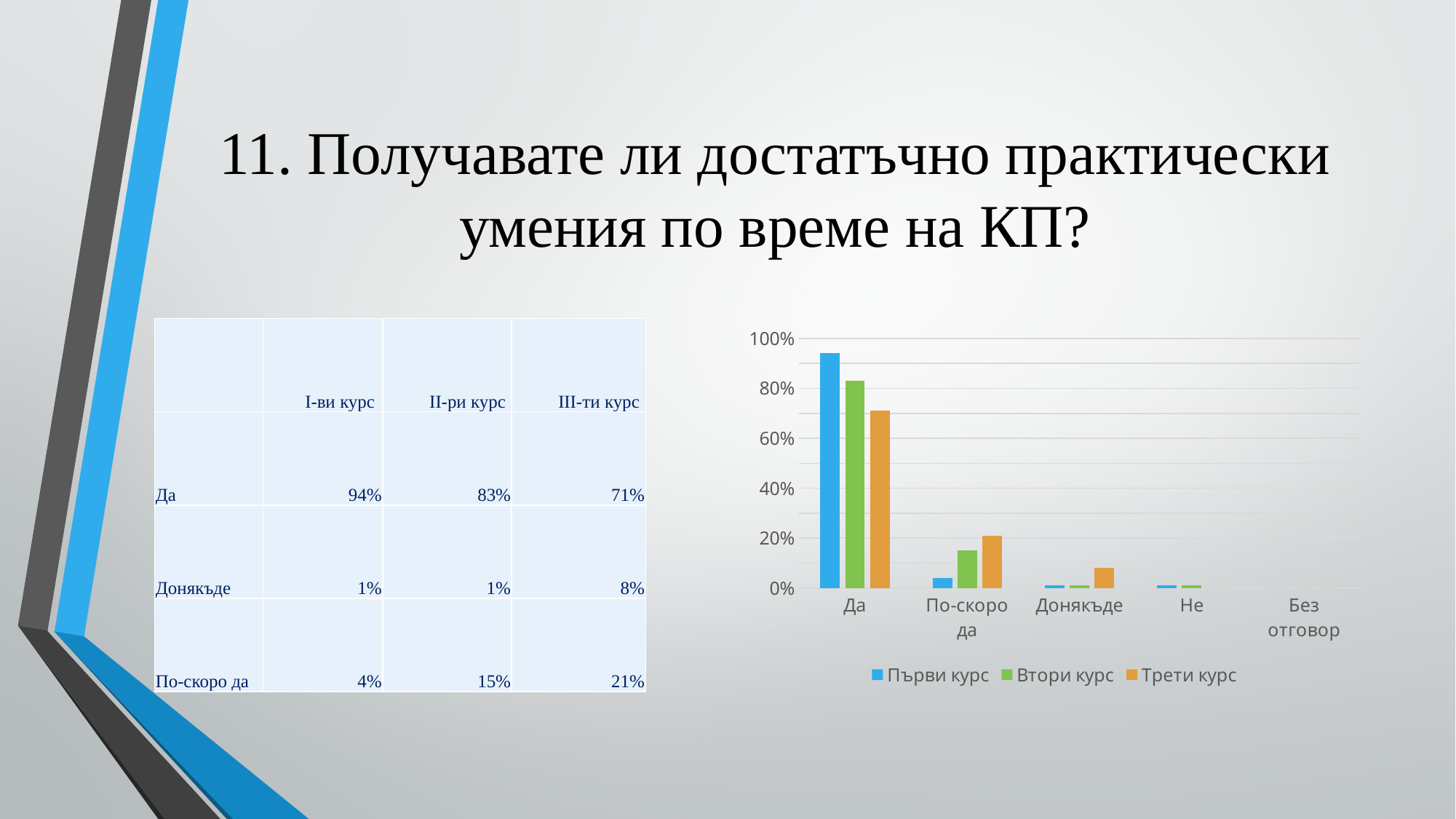
How many series does the chart legend list? 3 What is the value for Да for Първи курс? 94% Which series has the lowest value for По-скоро да? Първи курс Is the value for Да for Трети курс greater or less than 60%? greater What is the value for Донякъде for Трети курс? 8% Which series is shown in orange in the chart? Трети курс What kind of chart is shown on the slide? bar chart How many categories are shown along the x axis of the chart? 5 What is the difference between the Да values for Първи курс and Трети курс? 23% What is the value for По-скоро да for Трети курс? 21% Which is larger for По-скоро да: Втори курс or Трети курс? Трети курс Which series has the highest value for Да? Първи курс